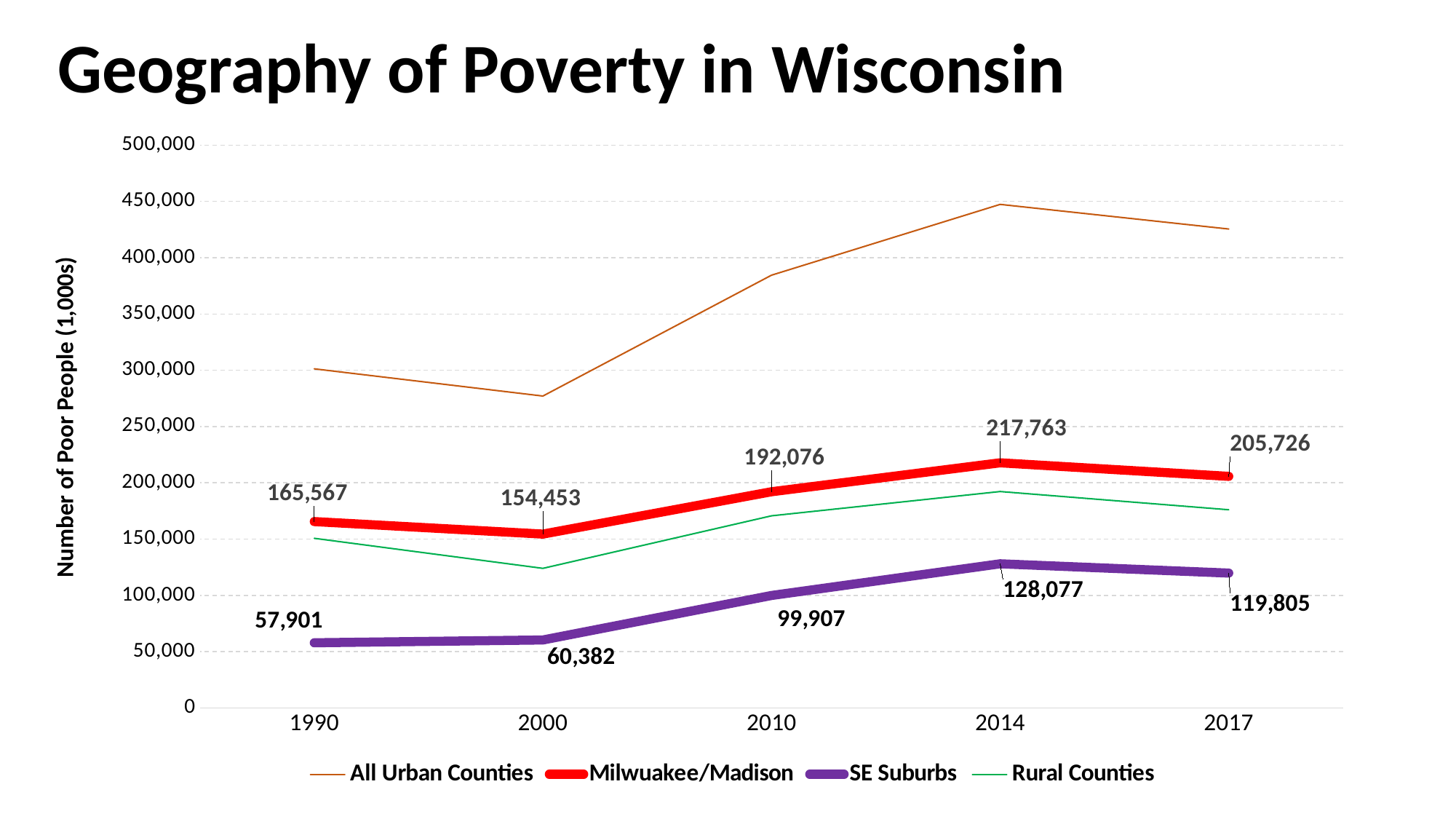
What is the value for Milwuakee/Madison in 2000? 154,453 What is the difference between the Milwuakee/Madison values in 2014 and 2017? 12,037 Which is larger: the SE Suburbs value in 2010 or in 2014? 2014 In which year is the SE Suburbs series lowest? 1990 How many series does the legend list? 4 What is the value for Milwuakee/Madison in 2014? 217,763 What is the value for SE Suburbs in 2017? 119,805 What is the label of the vertical axis? Number of Poor People (1,000s) What kind of chart is shown on the slide? line chart Is the value for All Urban Counties in 2014 greater or less than 400,000? greater What is the value for SE Suburbs in 1990? 57,901 In which year is the Milwuakee/Madison series highest? 2014